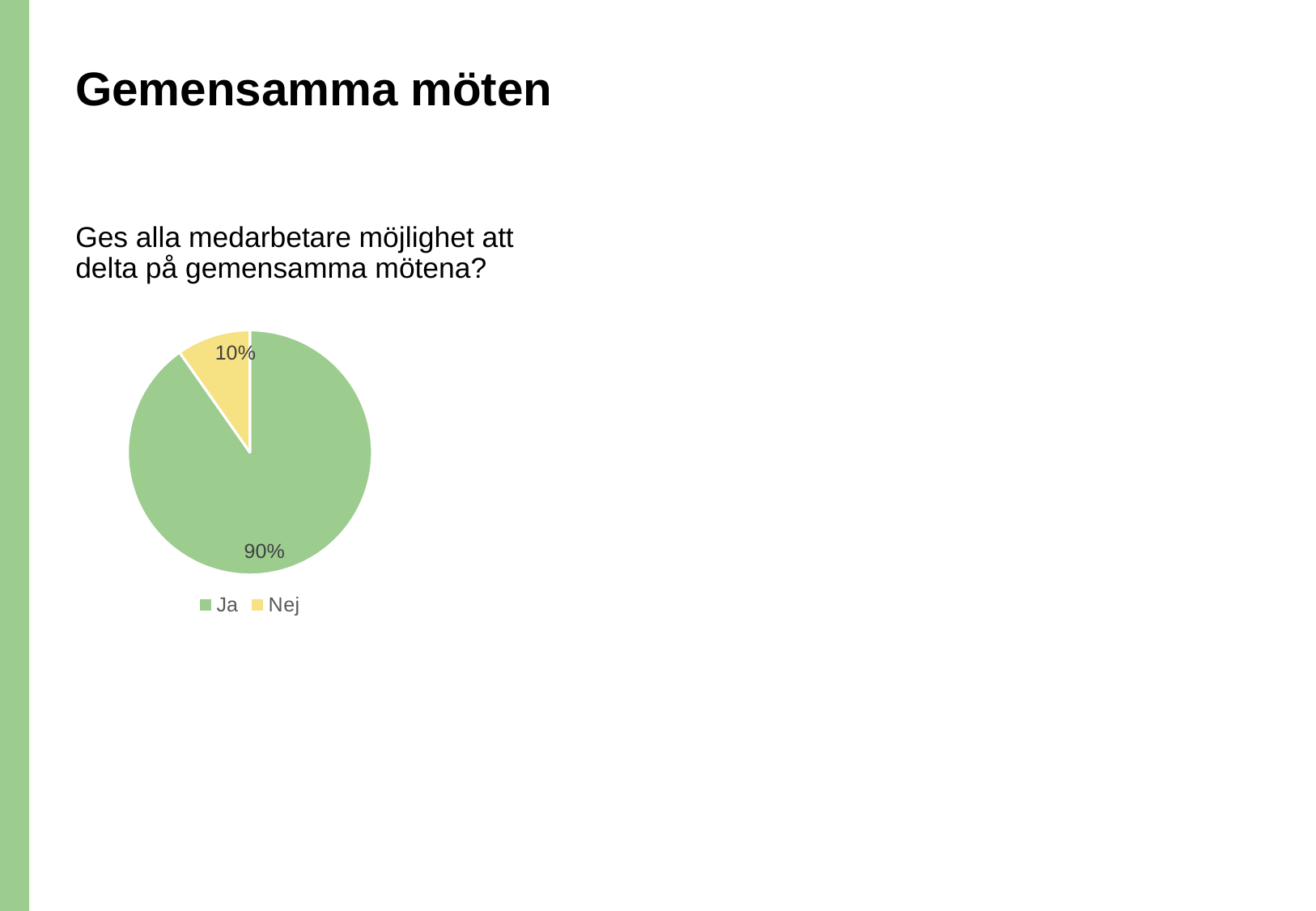
What is the difference in percentage points between the "Ja" and "Nej" slices? 80 What percentage of the pie is labelled "Ja"? 90% What percentage of the pie is labelled "Nej"? 10% Which slice of the pie is the largest? Ja How many entries does the legend list? 2 What kind of chart is shown on the slide? pie chart Which is larger, the "Ja" slice or the "Nej" slice? Ja Which slice of the pie is the smallest? Nej What colour is the "Ja" slice in the pie chart? green What question is the pie chart answering, as written above it? Ges alla medarbetare möjlighet att delta på gemensamma mötena? How many slices does the pie chart have? 2 What share of the pie does the "Nej" slice represent? 10%